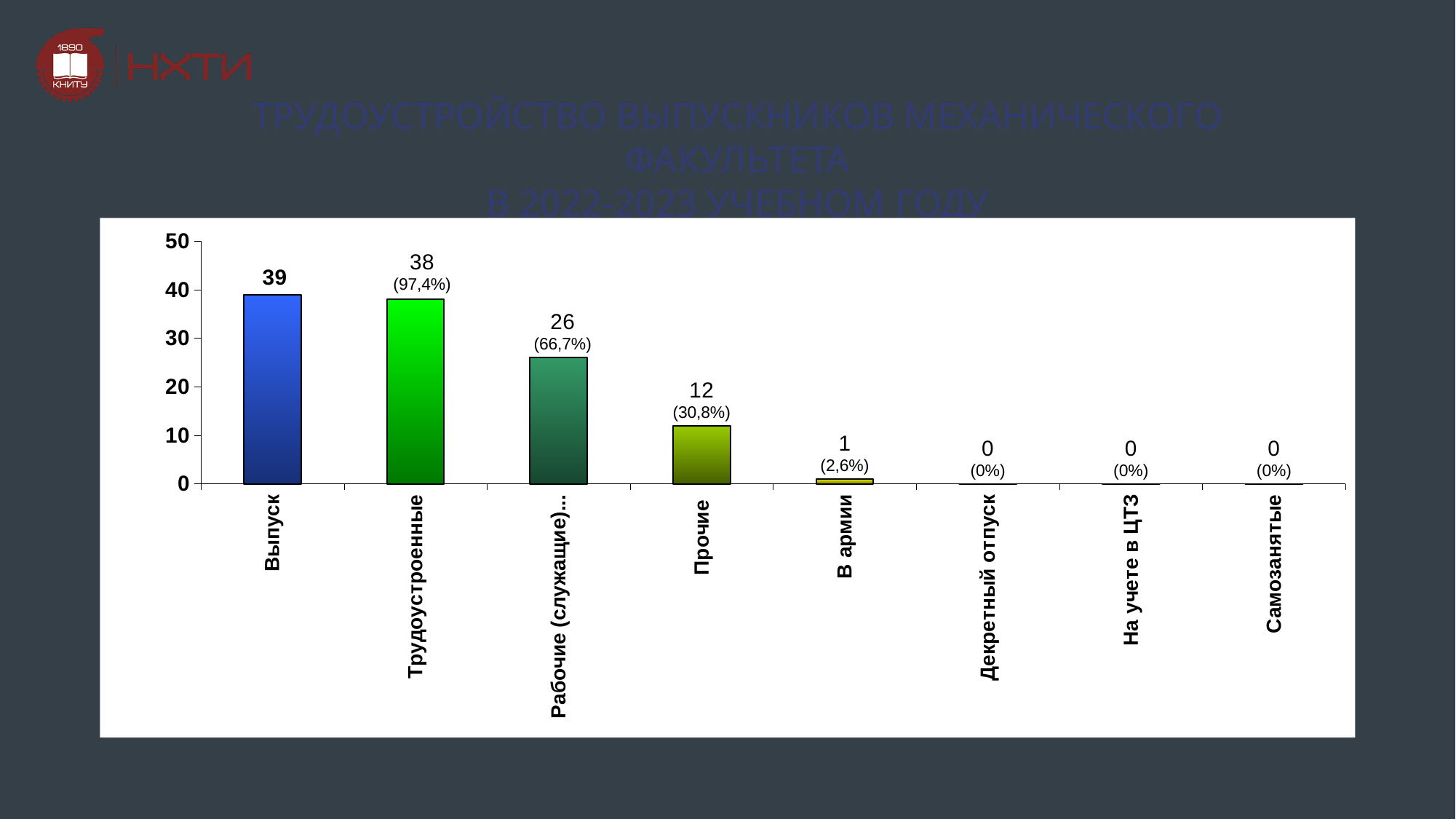
What is the difference between the values for Рабочие (служащие)... and Прочие? 14 What percentage is shown for Трудоустроенные? 97,4% How many categories are shown on the x axis? 8 Which category has the highest value? Выпуск What is the difference between the values for Выпуск and Трудоустроенные? 1 What is the value for Трудоустроенные? 38 How many categories have a value of 0? 3 What kind of chart is shown on the slide? Bar chart What percentage is shown for Прочие? 30,8% What is the value for Выпуск? 39 What is the value for В армии? 1 Which is larger, the value for Прочие or the value for В армии? Прочие